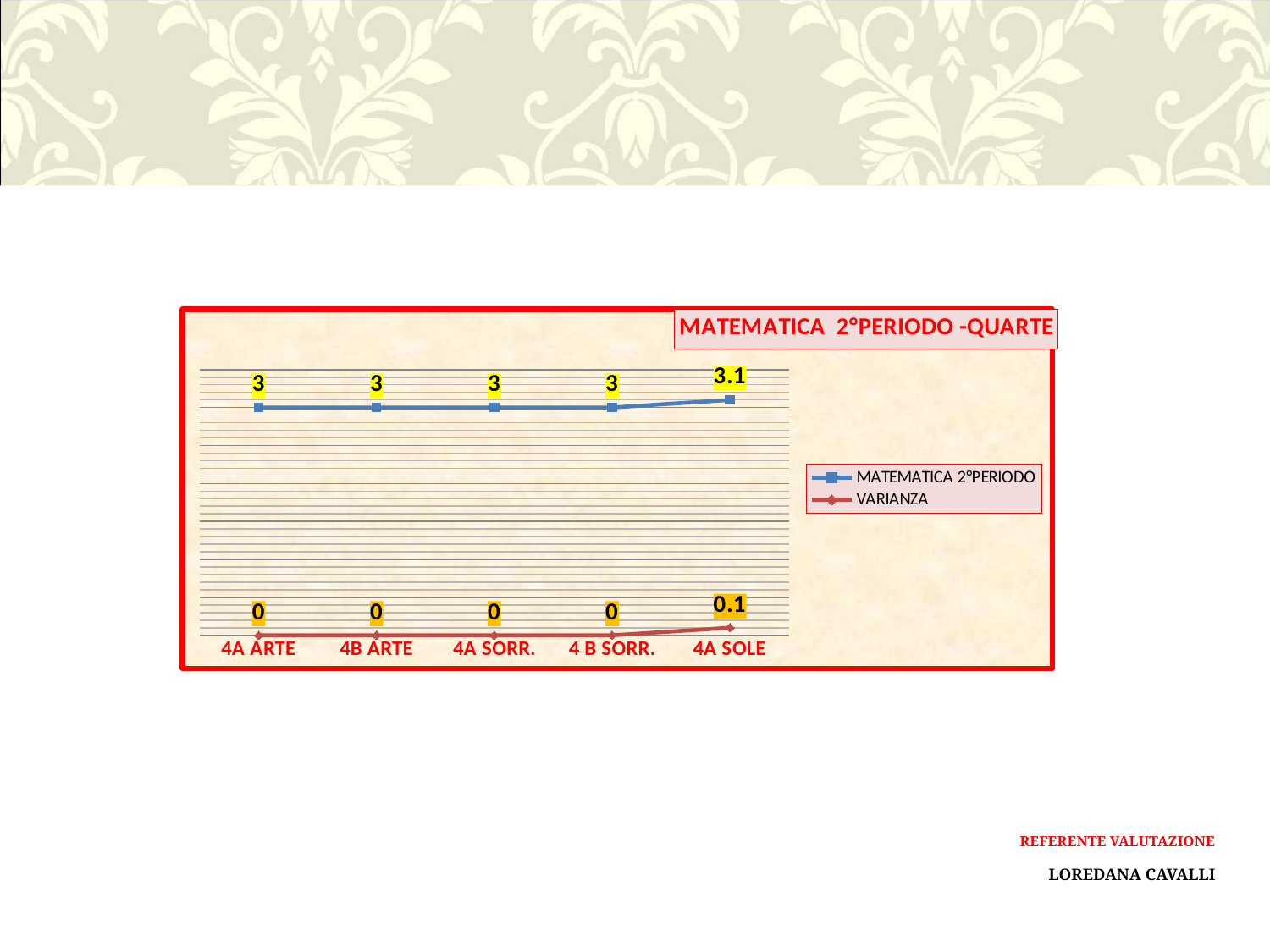
Which category has the highest MATEMATICA 2°PERIODO value? 4A SOLE What kind of chart is shown? line chart What is the title of the chart? MATEMATICA 2°PERIODO -QUARTE What is the MATEMATICA 2°PERIODO value for 4B ARTE? 3 Which is larger, the MATEMATICA 2°PERIODO value for 4A SOLE or for 4A ARTE? 4A SOLE How many series does the legend list? 2 What is the difference between the MATEMATICA 2°PERIODO values for 4A SOLE and 4 B SORR.? 0.1 How many categories are shown on the x axis? 5 What is the MATEMATICA 2°PERIODO value for 4A SOLE? 3.1 What is the VARIANZA value for 4A SOLE? 0.1 What is the VARIANZA value for 4A SORR.? 0 Which category has the highest VARIANZA value? 4A SOLE